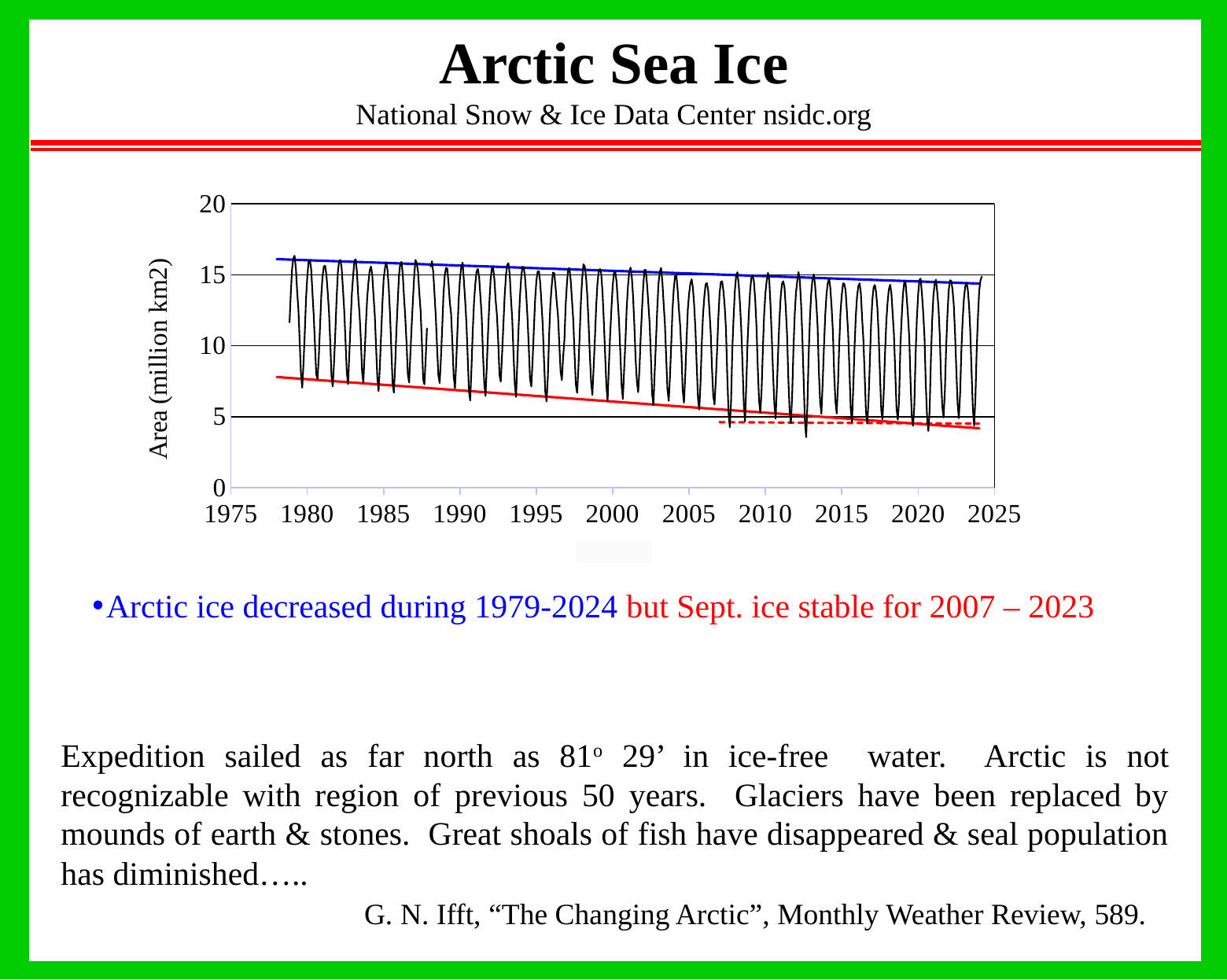
Is the peak ice area around 1980 greater or less than 15 million km2? greater Is the minimum ice area around 1980 greater or less than 5 million km2? greater Does the red trend line through the annual minima rise or fall from 1979 to 2024? fall Which is larger, the peak ice area around 1980 or the peak ice area around 2020? around 1980 Does the blue trend line through the annual maxima rise or fall from 1979 to 2024? fall What is the title of the slide containing the chart? Arctic Sea Ice Is the minimum ice area around 2012 greater or less than 5 million km2? less What kind of chart is shown on the slide? line chart Which is larger, the minimum ice area around 1980 or the minimum ice area around 2020? around 1980 What is the label on the vertical axis of the chart? Area (million km2)